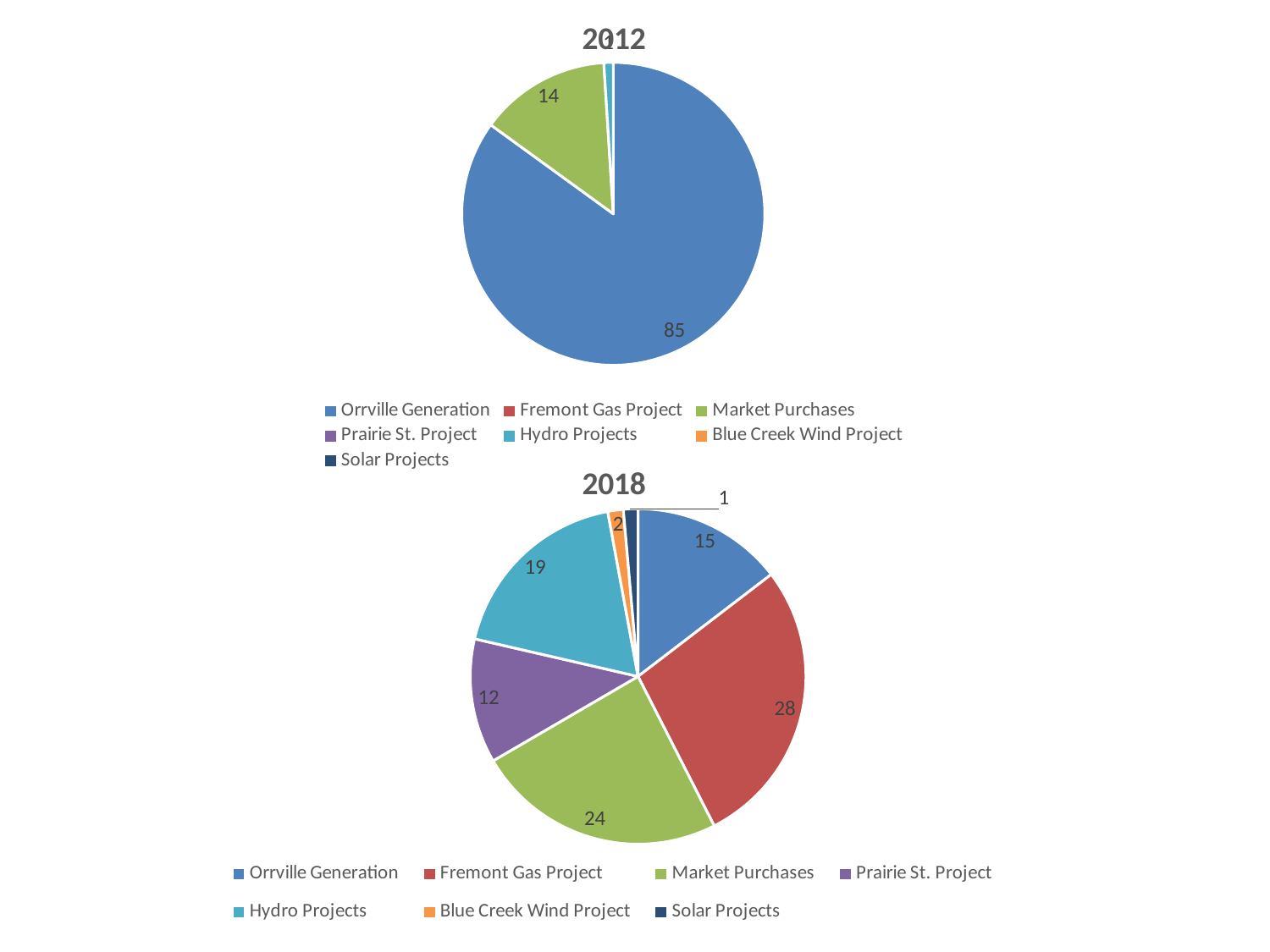
In the 2012 chart, what is the value for Market Purchases? 14 In the 2018 chart, which category has the largest slice? Fremont Gas Project In the 2018 chart, which category has the smallest slice? Solar Projects In the 2018 chart, which is larger, Orrville Generation or Hydro Projects? Hydro Projects In the 2018 chart, what is the value for Hydro Projects? 19 In the 2012 chart, what is the difference between Orrville Generation and Market Purchases? 71 In the 2018 chart, what is the value for Fremont Gas Project? 28 What kind of chart is the 2012 chart? Pie chart In the 2018 chart, what is the difference between Fremont Gas Project and Market Purchases? 4 In the 2018 chart, what is the value for Prairie St. Project? 12 How many entries does the legend of the 2018 chart list? 7 In the 2012 chart, what is the value for Orrville Generation? 85